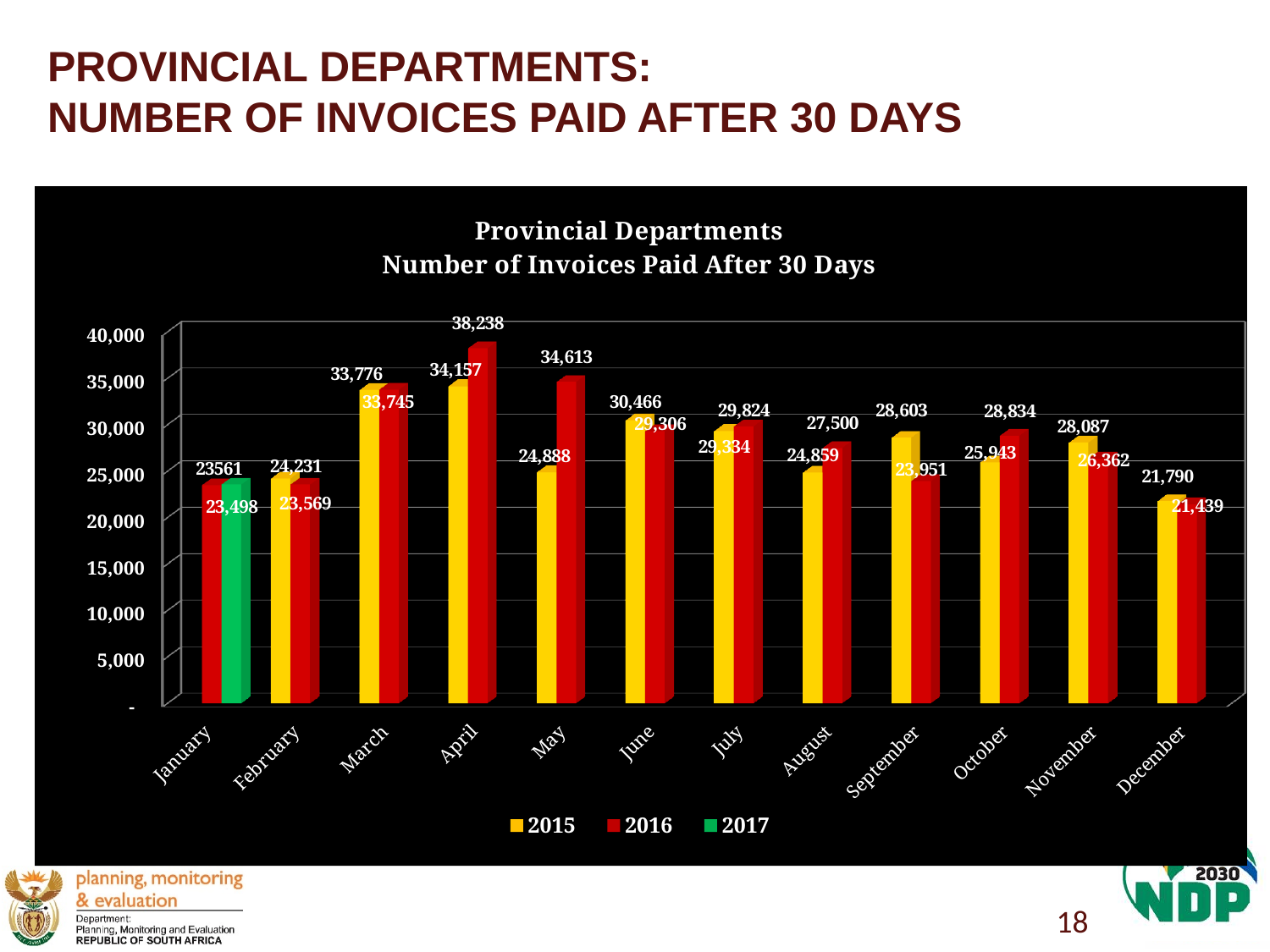
What is the value for October in the 2016 series? 28,834 Is the 2015 value for March greater or less than 30,000? greater What is the value for May in the 2015 series? 24,888 In which month is the 2016 value highest? April What is the difference between the 2016 and 2015 values for April? 4,081 How many months are shown on the x axis? 12 In which month is the 2015 value lowest? December What colour represents the 2017 series in the legend? Green What is the number of invoices paid after 30 days in April for 2016? 38,238 Which series has the larger value in May, 2015 or 2016? 2016 What kind of chart is shown on the slide? Bar chart How many series does the legend list? 3